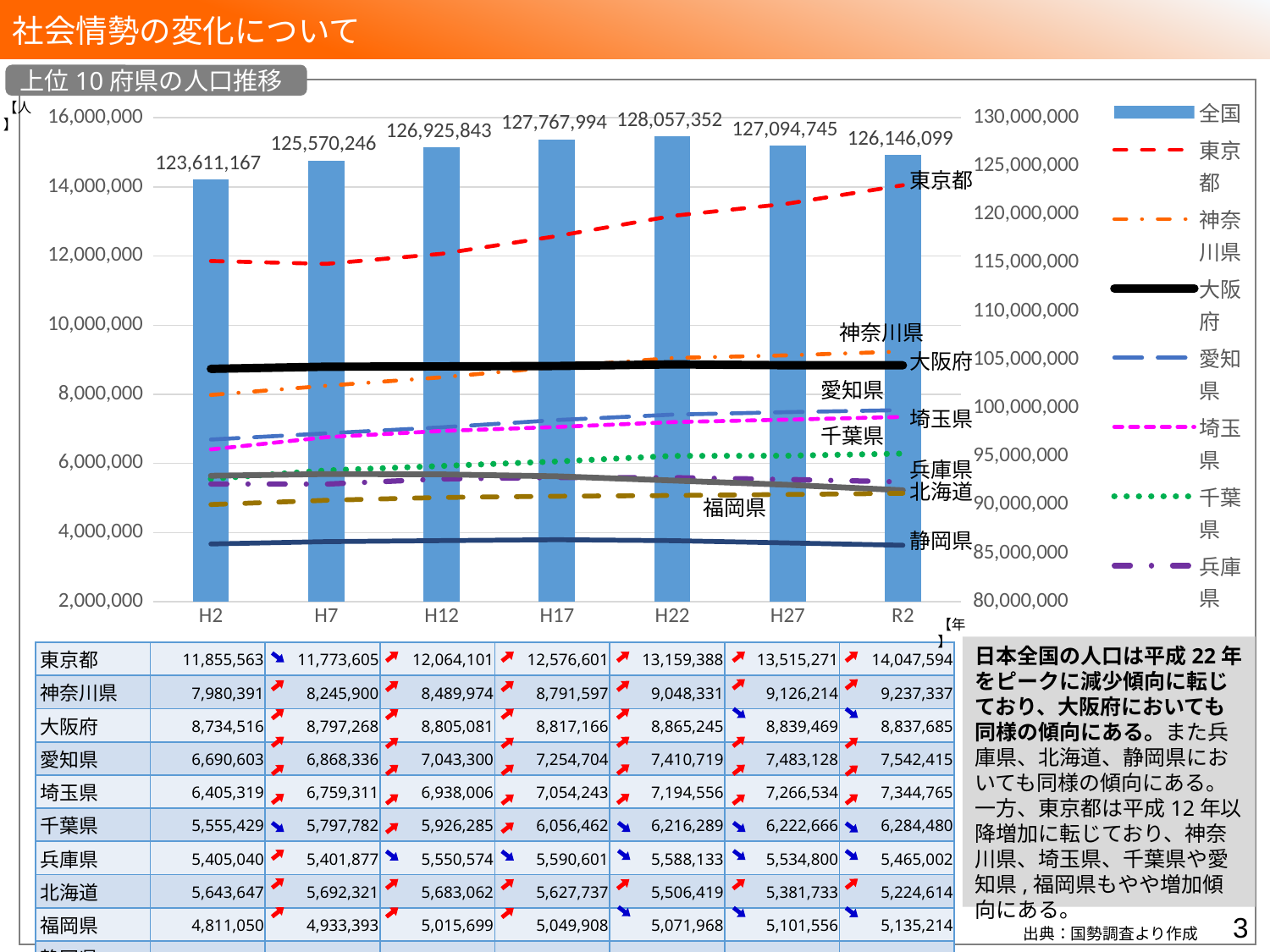
What kind of chart is shown on the slide? bar and line chart What is the difference between the 全国 values at H7 and H2? 1,959,079 In which year is the 全国 bar highest? H22 How many years are plotted on the x axis? 7 In which year is the 全国 bar lowest? H2 Which is larger, the 全国 value at H7 or at H27? H27 What colour are the 全国 bars? blue Is the value for 大阪府 at H2 greater or less than 8,000,000? greater What is the value of 全国 at H2? 123,611,167 Does the 東京都 line rise or fall from H12 to R2? rise What is the value of 全国 at H22? 128,057,352 What is the difference between the 全国 values at H22 and R2? 1,911,253